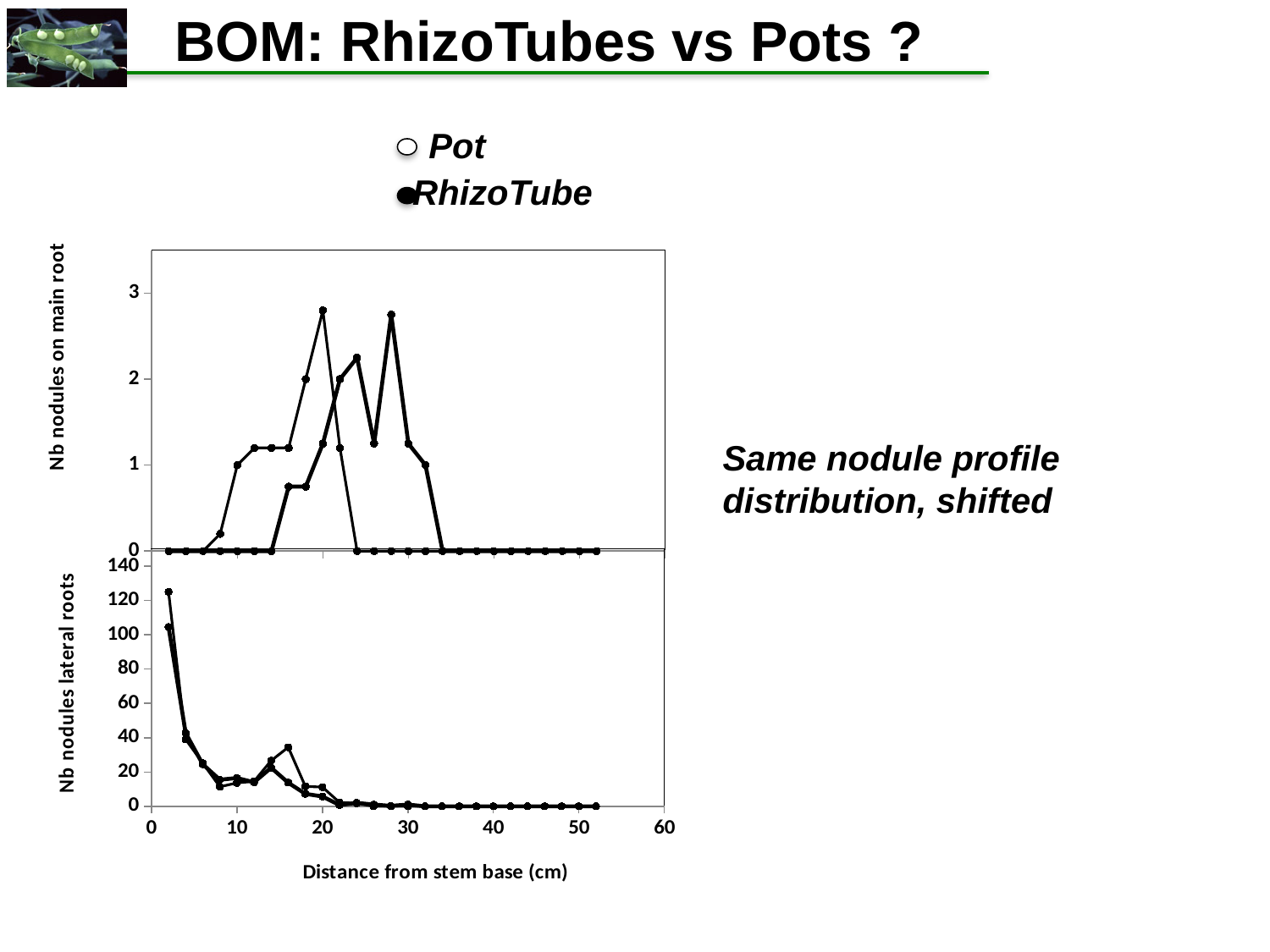
In the top chart (Nb nodules on main root), is the RhizoTube value at 28 cm greater or less than 2? greater In the bottom chart (Nb nodules lateral roots), are the values at 30 cm greater or less than 20? less What are the two series named in the legend? Pot and RhizoTube What is the highest tick value shown on the x axis? 60 What kind of chart is the top chart (Nb nodules on main root)? line chart In the bottom chart (Nb nodules lateral roots), do the values generally rise or fall as distance from the stem base increases? fall In the top chart (Nb nodules on main root), is the Pot value at 10 cm greater or less than 2? less How many series does the legend list? 2 What is the x-axis title of the charts? Distance from stem base (cm)